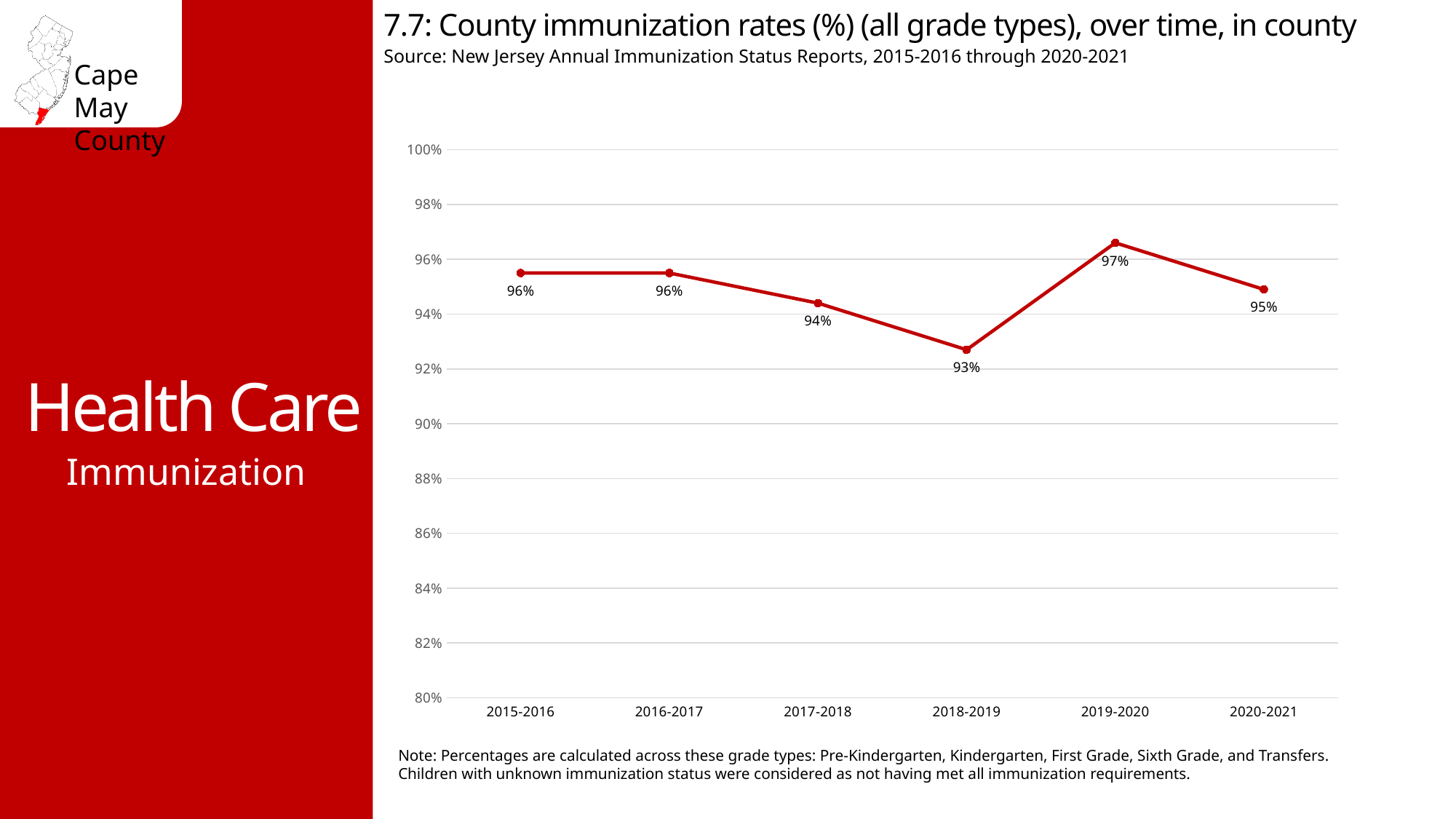
What kind of chart is shown on the slide? line chart Is the value for 2018-2019 greater or less than 94%? less What is the difference in percentage points between the 2019-2020 rate and the 2018-2019 rate? 4 How many school years are plotted on the chart? 6 What was the county immunization rate in 2020-2021? 95% Which school year had the lowest immunization rate? 2018-2019 What was the county immunization rate in 2017-2018? 94% Which year had a higher immunization rate, 2017-2018 or 2020-2021? 2020-2021 Which school year had the highest immunization rate? 2019-2020 What was the county immunization rate in 2019-2020? 97% Did the immunization rate rise or fall from 2019-2020 to 2020-2021? fall What was the county immunization rate in 2018-2019? 93%